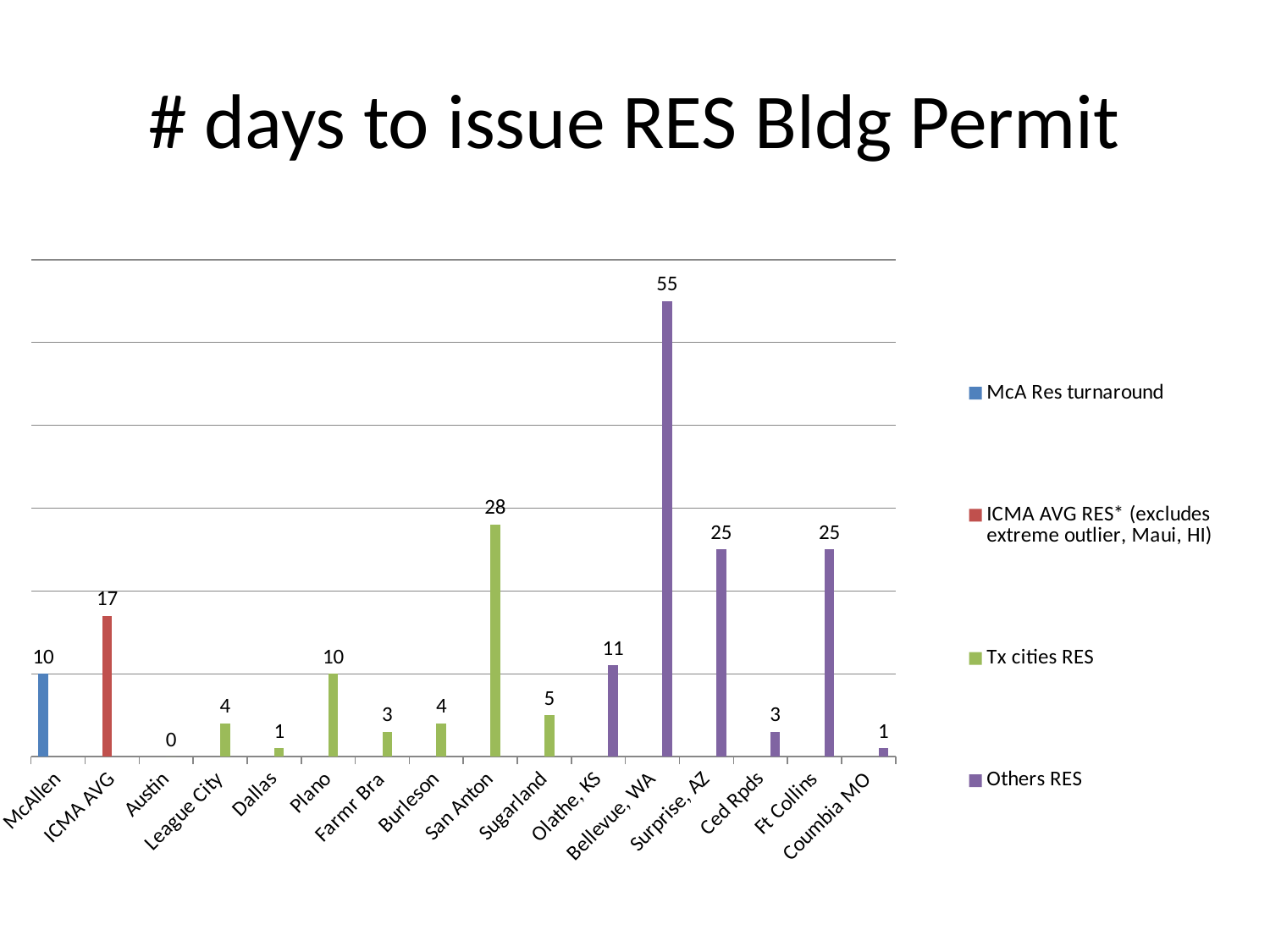
What is the title of the chart? # days to issue RES Bldg Permit What is the value for ICMA AVG? 17 What is the value for McAllen? 10 How many categories are shown on the x axis? 16 What is the value for San Anton? 28 Which category has the highest value? Bellevue, WA How many series does the legend list? 4 What kind of chart is shown on the slide? Bar chart What is the value for Bellevue, WA? 55 Which category has the lowest value? Austin Which is larger, the value for ICMA AVG or the value for McAllen? ICMA AVG What is the difference between the values for Bellevue, WA and San Anton? 27